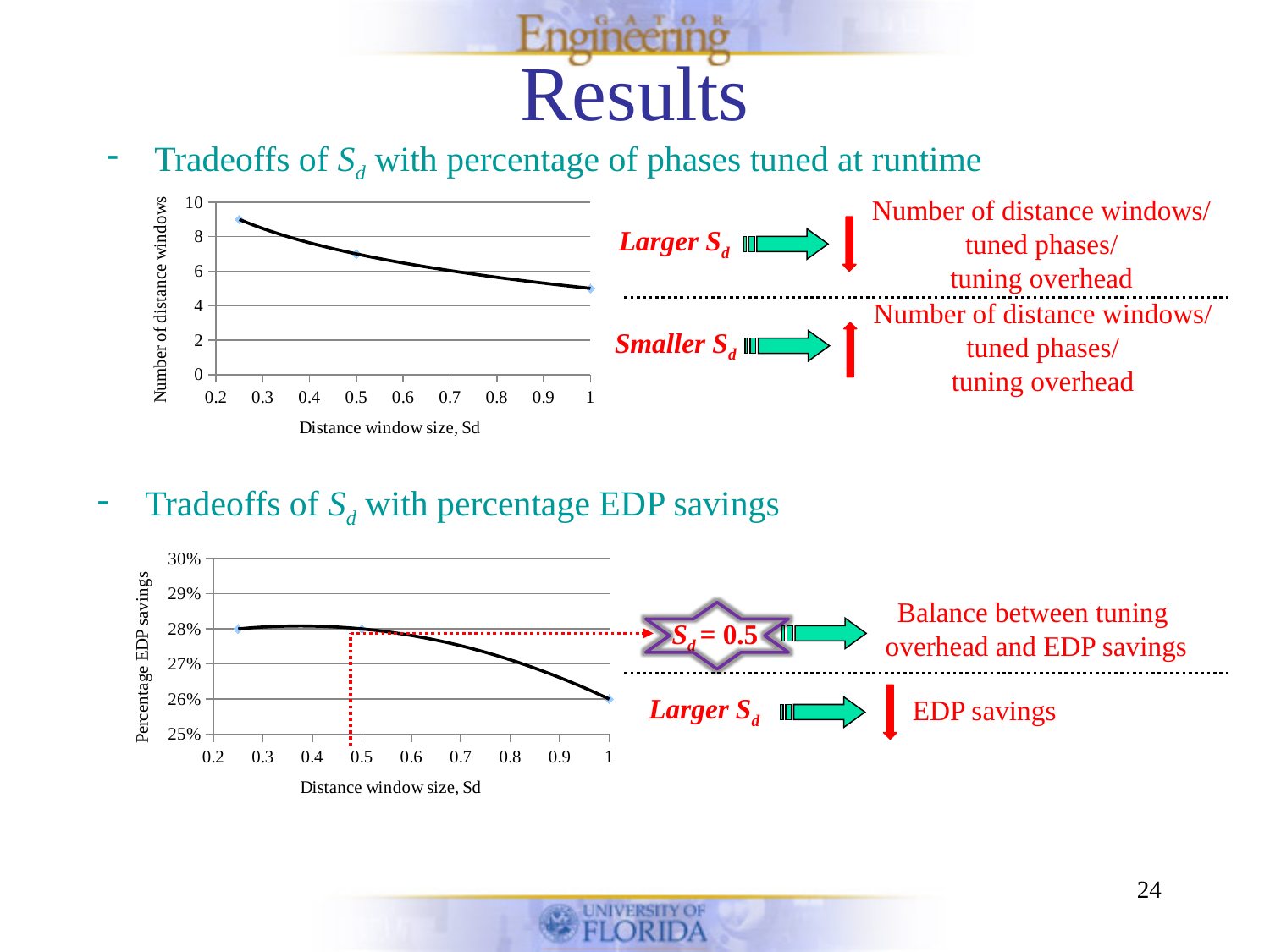
In the top chart, is the number of distance windows at Sd = 0.5 greater or less than 8? less How many data points are plotted in the bottom chart? 3 In the bottom chart (Percentage EDP savings), what is the percentage EDP savings at Sd = 1? 26% In the top chart, is the number of distance windows at Sd = 0.25 greater or less than 8? greater In the top chart, does the number of distance windows rise or fall as the distance window size increases? fall In the top chart, is the number of distance windows at Sd = 1 greater or less than 6? less What is the y-axis title of the top chart? Number of distance windows In the top chart, which distance window size has the highest number of distance windows? 0.25 What kind of chart is the top chart (Number of distance windows vs Distance window size)? line chart In the bottom chart, which has the larger percentage EDP savings, Sd = 0.25 or Sd = 1? Sd = 0.25 In the bottom chart, what is the percentage EDP savings at Sd = 0.5? 28% In the bottom chart, what is the difference in percentage EDP savings between Sd = 0.5 and Sd = 1? 2%